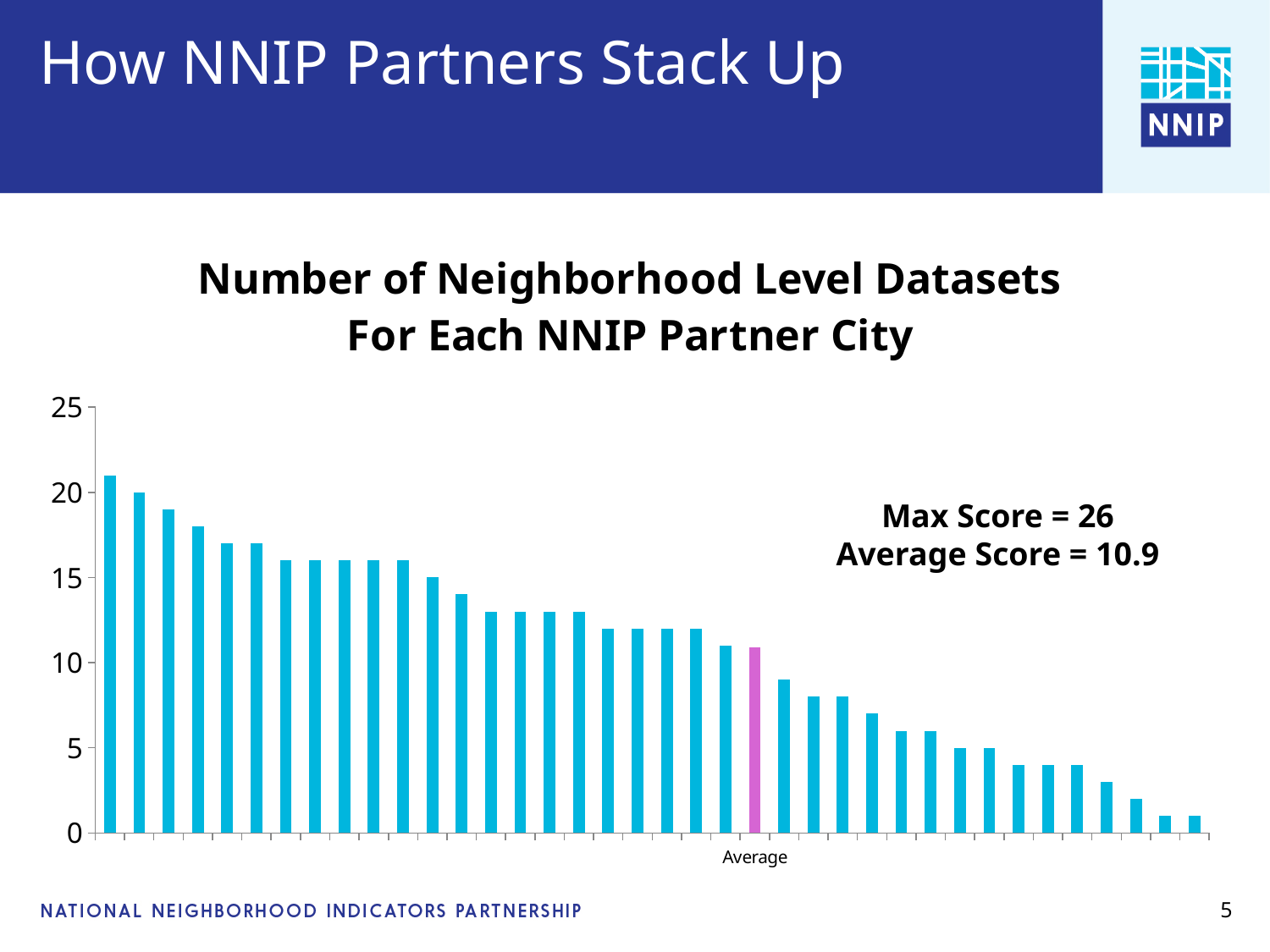
Is the value of the tallest bar greater or less than 20? greater What is the value of the bar labelled Average? 10.9 What is the highest value shown on the y axis? 25 Is the value for the Average bar greater or less than 15? less Which is larger, the leftmost bar or the Average bar? the leftmost bar What kind of chart is shown on the slide? bar chart Do the bar values rise or fall from left to right along the x axis? fall Which is larger, the Average bar or the bar immediately to its right? Average What colour is the Average bar, which differs from the other bars? pink/purple What is the title of the chart? Number of Neighborhood Level Datasets For Each NNIP Partner City